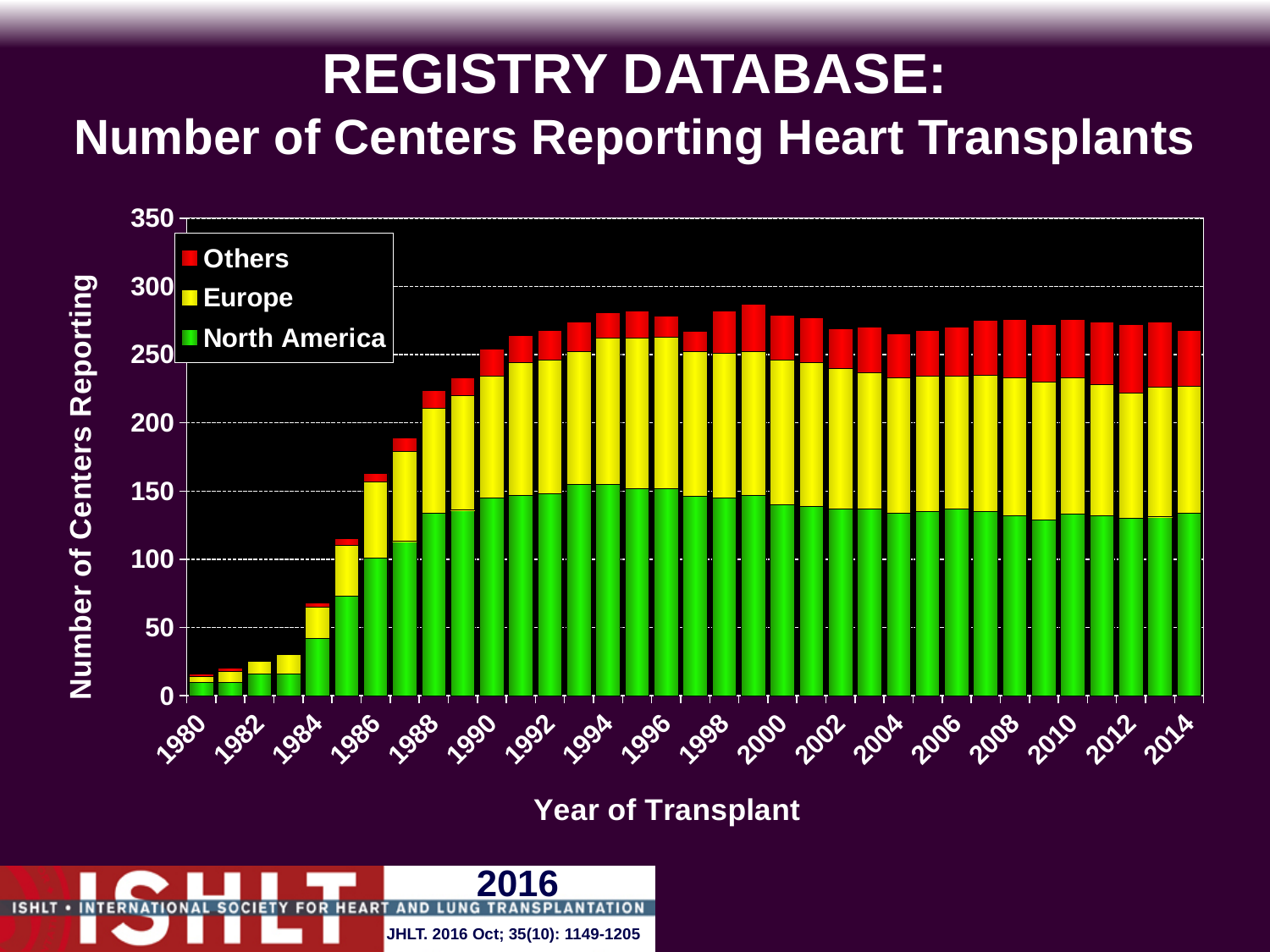
Which year has the lowest total number of centers reporting? 1980 Which year has the larger total number of centers reporting, 1984 or 2000? 2000 Does the total number of centers reporting rise or fall from 1980 to 1990? rise Is the number of North American centers reporting in 2014 greater or less than 150? less How many years (bars) are plotted on the x axis? 35 What kind of chart is shown on the slide? stacked bar chart Is the total number of centers reporting in 2014 greater or less than 250? greater Which colour represents the 'Others' series in the legend? red Is the total number of centers reporting in 1988 greater or less than 200? greater How many series does the legend list? 3